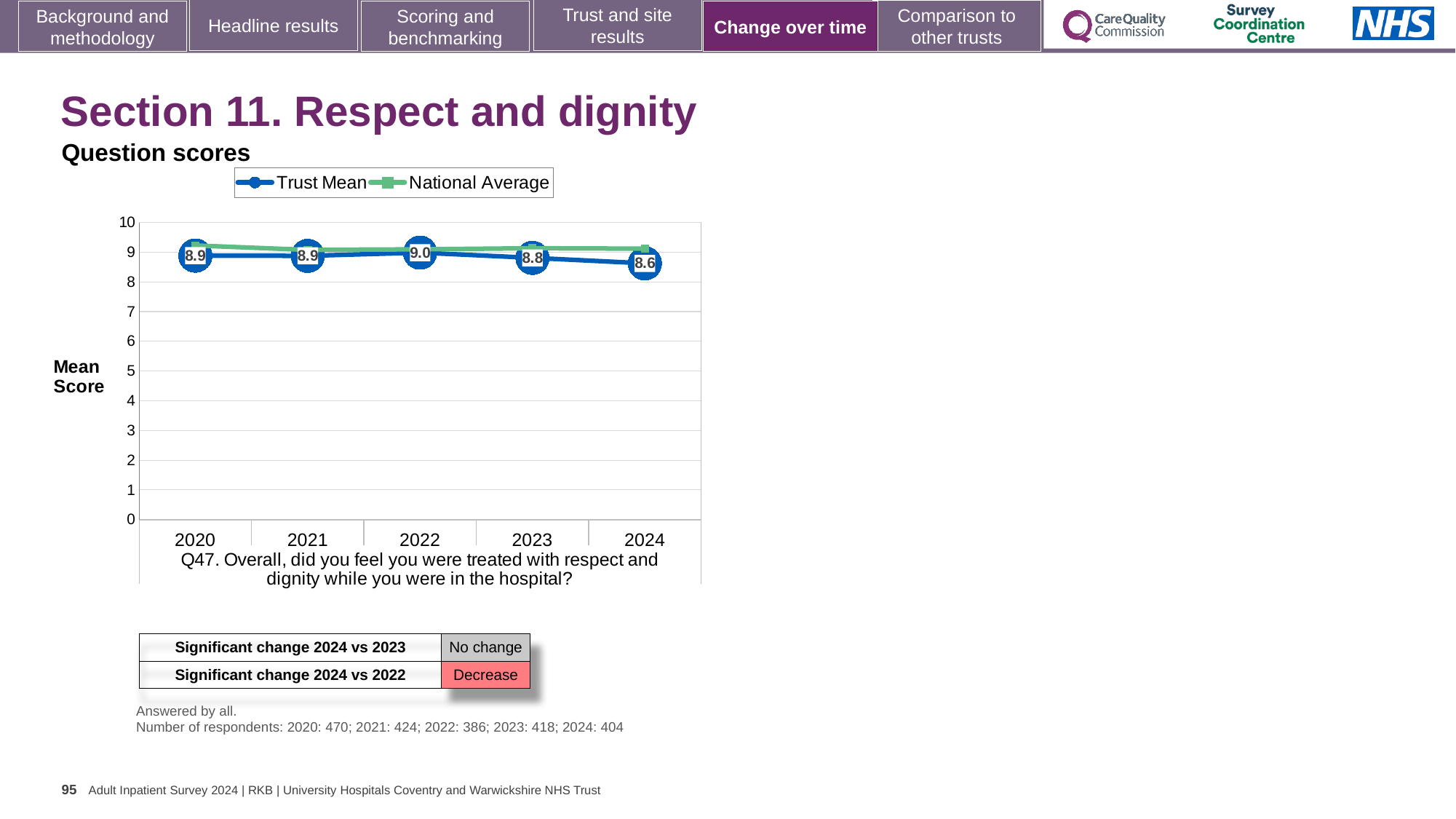
How many years are plotted on the x axis? 5 In which year is the Trust Mean highest? 2022 What is the Trust Mean for 2020? 8.9 How many series does the legend list? 2 What is the difference between the Trust Mean in 2022 and in 2024? 0.4 In which year is the Trust Mean lowest? 2024 Does the Trust Mean rise or fall from 2022 to 2024? fall What is the Trust Mean for 2024? 8.6 What kind of chart is shown? line chart Is the National Average for 2024 greater or less than 8? greater What is the Trust Mean for 2022? 9.0 Which is larger, the Trust Mean in 2023 or in 2024? 2023